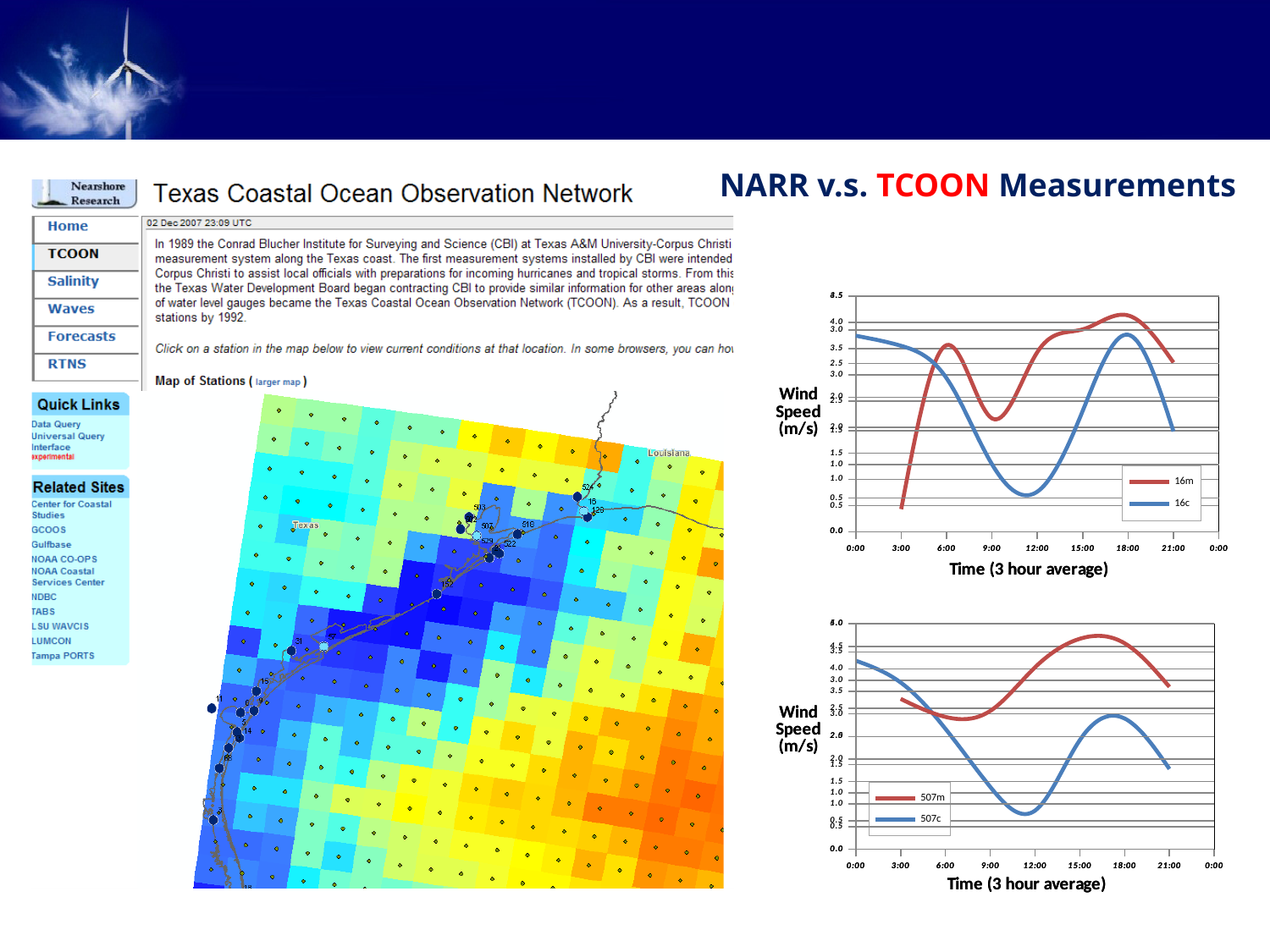
What kind of chart is the top chart on the right of the slide? line chart In the top chart, does the 16c series rise or fall between 0:00 and 12:00? fall In the bottom chart, which series is drawn in blue? 507c In the bottom chart, is the value of 507c at 12:00 greater or less than 2.0? less In the bottom chart, which series has the higher value at 12:00, 507m or 507c? 507m In the top chart, which series has the higher value at 12:00, 16m or 16c? 16m How many series does the legend of the top chart list? 2 What kind of chart is the bottom chart on the right of the slide? line chart In the top chart, which series has the higher value at 3:00, 16m or 16c? 16c In the top chart, which series is drawn in red? 16m How many series does the legend of the bottom chart list? 2 In the bottom chart, does the 507m series rise or fall between 9:00 and 15:00? rise